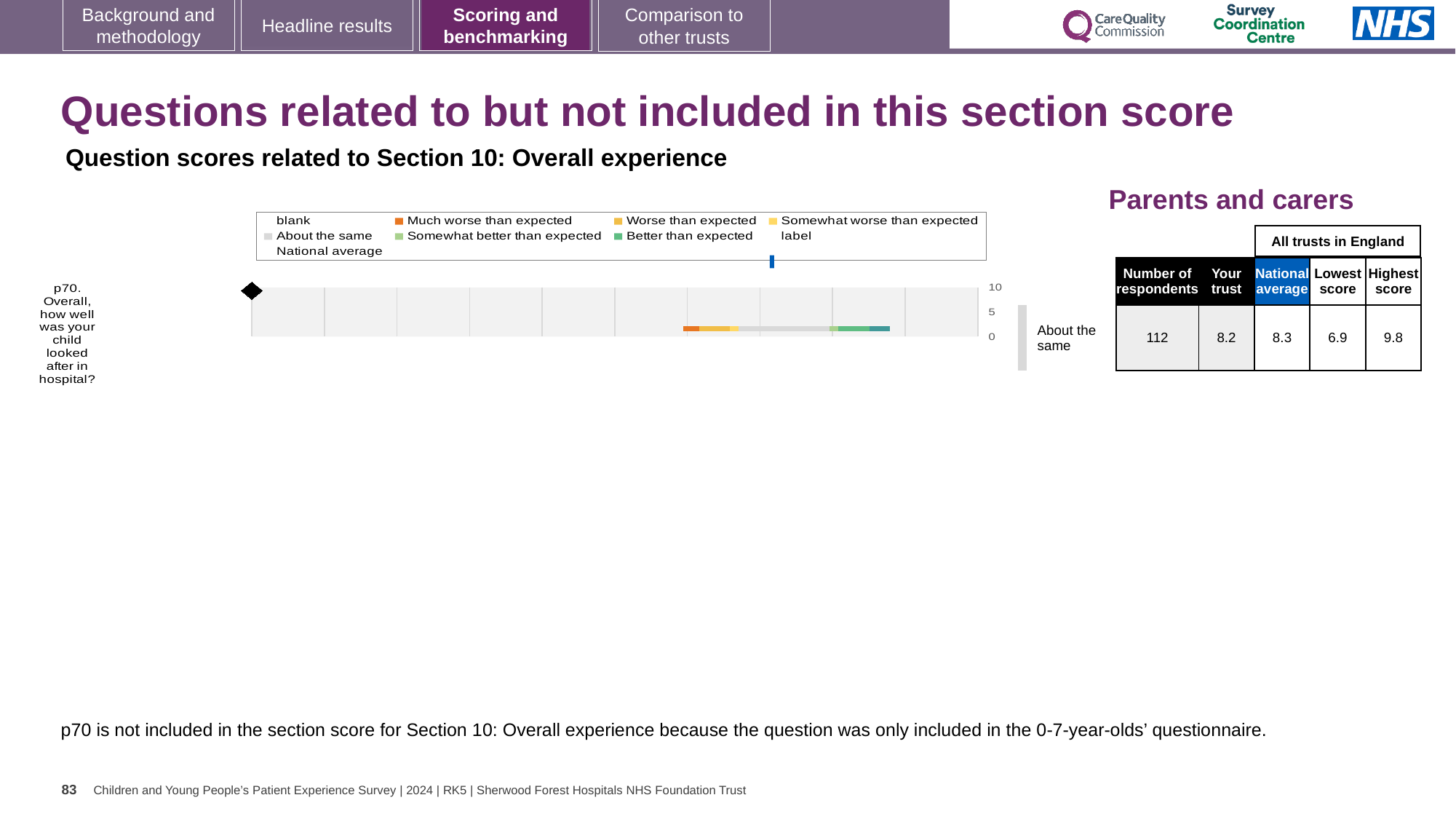
What benchmark category is shown next to the p70 bar? About the same What kind of chart is used to show the p70 question score? bar chart How many respondents answered p70? 112 What is the lowest score among all trusts in England for p70? 6.9 Which is larger for p70: the 'Your trust' score or the national average? National average What is the national average score for p70? 8.3 What is the 'Your trust' score for p70 (Overall, how well was your child looked after in hospital?)? 8.2 How many questions are plotted in the chart? 1 By how much does the national average exceed the 'Your trust' score for p70? 0.1 What is the difference between the highest and lowest trust scores for p70? 2.9 What is the highest score among all trusts in England for p70? 9.8 Which respondent group does the chart and table refer to? Parents and carers